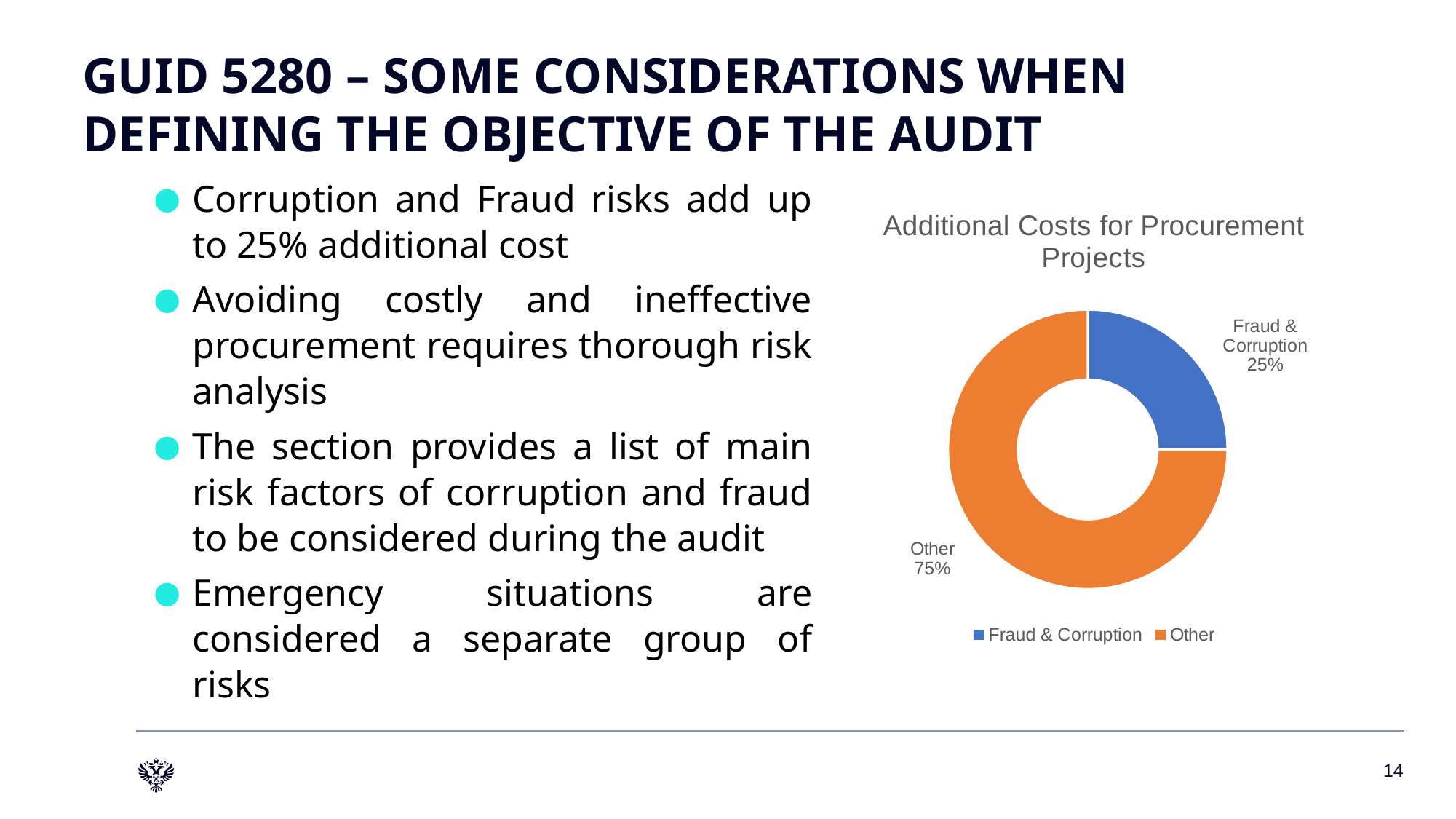
What colour represents Fraud & Corruption in the chart? Blue What share of additional costs for procurement projects is attributed to Other? 75% How many entries does the legend of the chart list? 2 Which category has the smallest share in the Additional Costs for Procurement Projects chart? Fraud & Corruption Which is larger: the share for Fraud & Corruption or the share for Other? Other Which category has the largest share in the Additional Costs for Procurement Projects chart? Other What is the title of the chart on the slide? Additional Costs for Procurement Projects What kind of chart is shown on the slide? Doughnut (pie) chart How many categories are shown in the Additional Costs for Procurement Projects chart? 2 What is the difference in percentage points between the Other share and the Fraud & Corruption share? 50 What share of additional costs for procurement projects is attributed to Fraud & Corruption? 25%